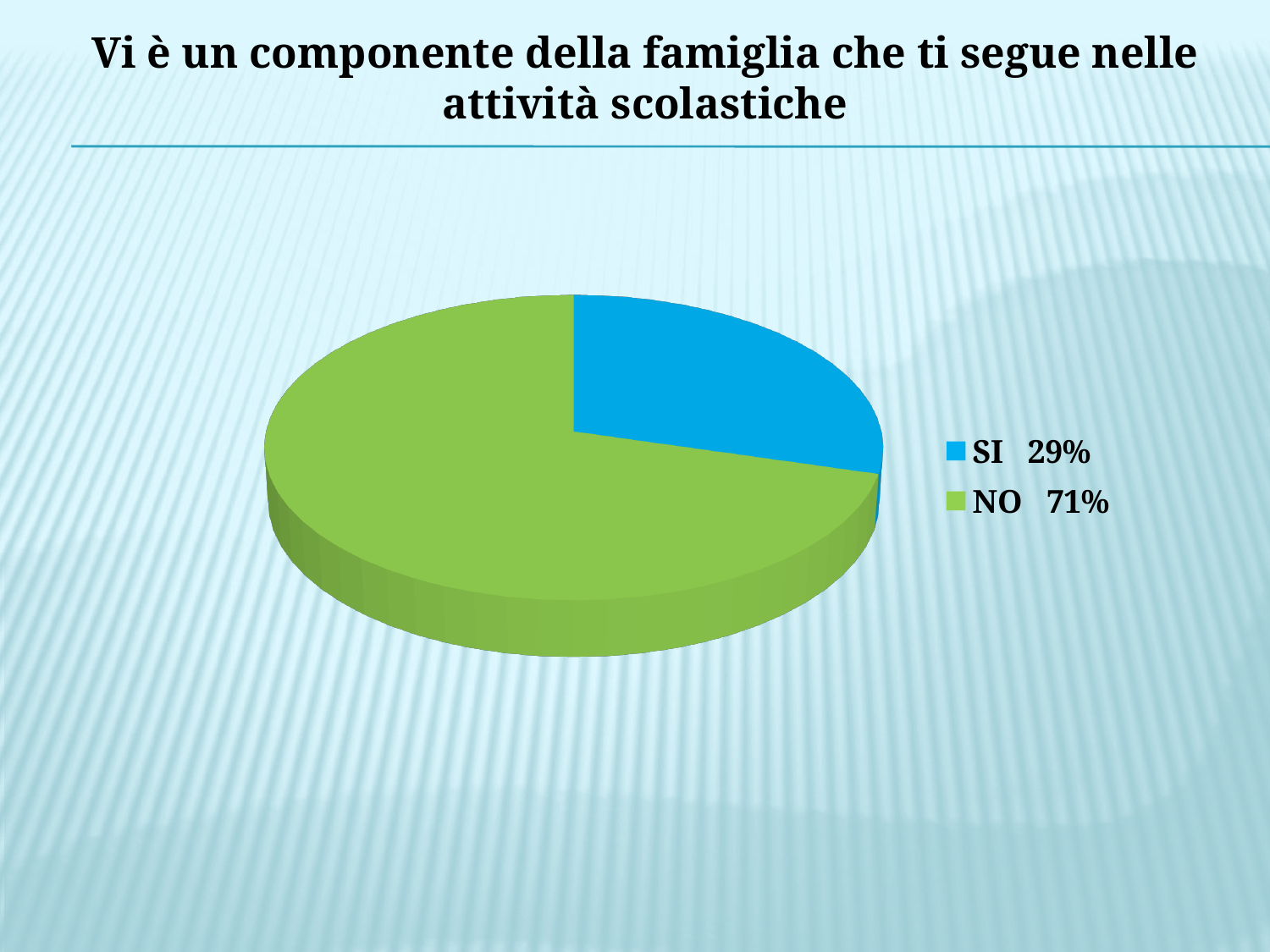
What share of the pie does the SI slice represent? 29% Which category has the smallest slice of the pie? SI How many entries does the legend list? 2 What kind of chart is shown on the slide? pie chart What is the difference in percentage points between the NO and SI slices? 42 What share of the pie does the NO slice represent? 71% What colour is the NO slice? green Which is larger, the SI slice or the NO slice? NO What colour is the SI slice? blue How many slices does the pie chart have? 2 Which category has the largest slice of the pie? NO